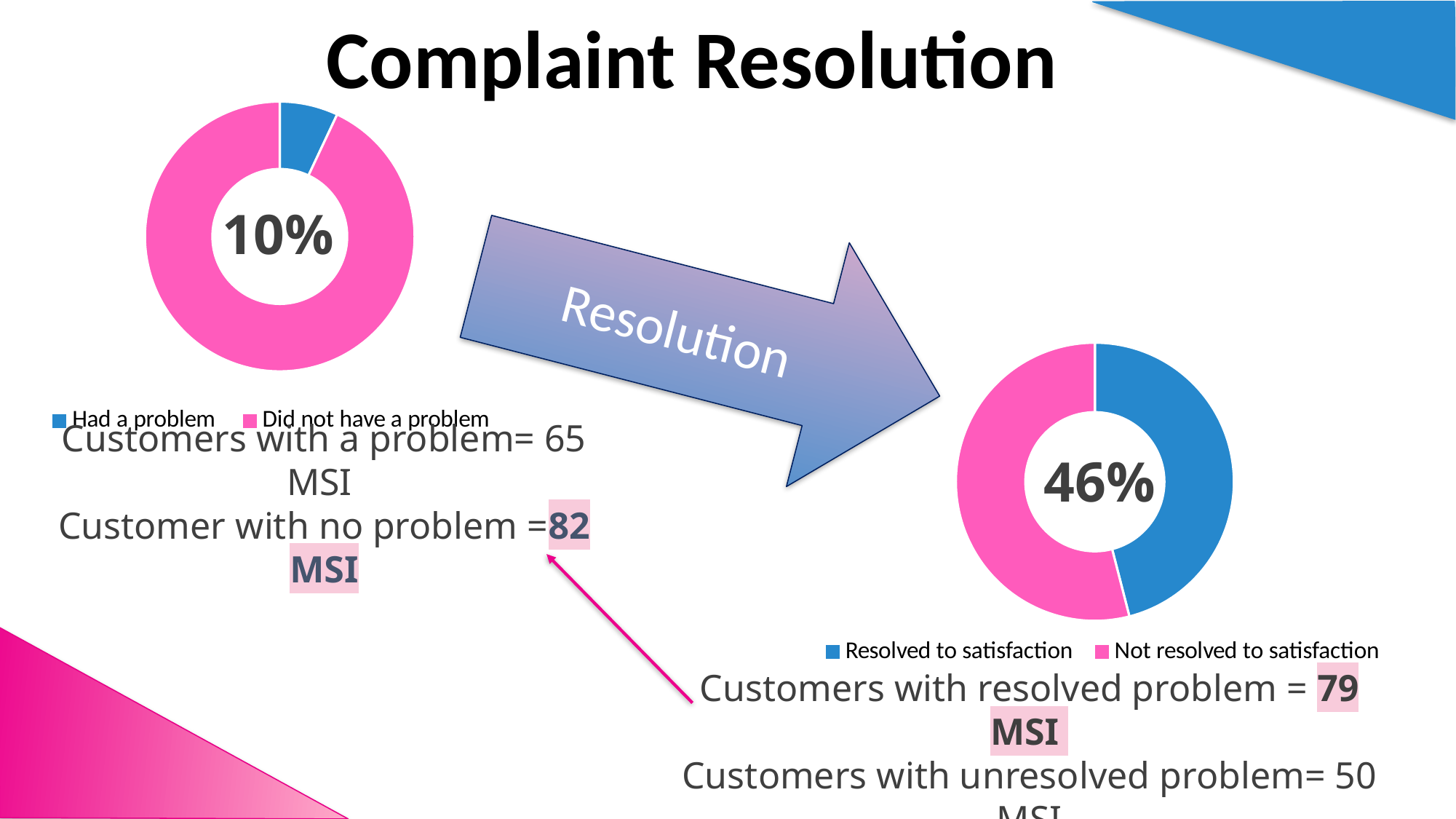
In the left chart, which colour represents 'Had a problem'? Blue In the right chart, what share of problems were resolved to satisfaction? 46% What kind of chart is the chart on the left of the slide? Doughnut (pie) chart In the right chart, which slice is larger: 'Resolved to satisfaction' or 'Not resolved to satisfaction'? Not resolved to satisfaction What kind of chart is the chart on the right of the slide? Doughnut (pie) chart In the right chart, which colour represents 'Not resolved to satisfaction'? Pink In the left chart, what percentage is shown in the centre of the doughnut? 10% How many categories does the legend of the left chart list? 2 How many categories does the legend of the right chart list? 2 In the right chart, what percentage is shown in the centre of the doughnut? 46% In the left chart, which slice is larger: 'Had a problem' or 'Did not have a problem'? Did not have a problem